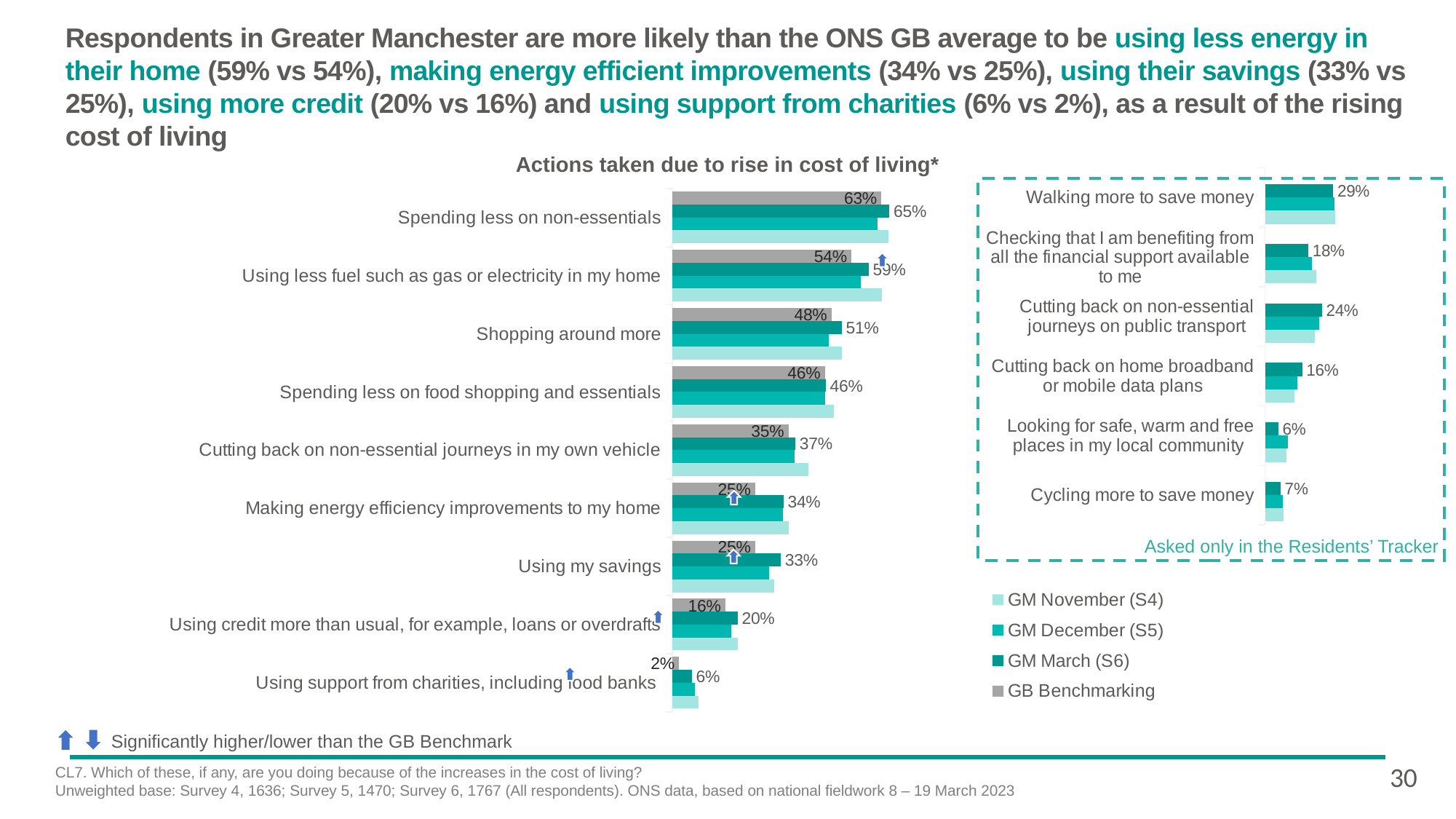
In the 'Actions taken due to rise in cost of living' chart, what is the GB Benchmarking value for 'Using less fuel such as gas or electricity in my home'? 54% In the 'Actions taken due to rise in cost of living' chart, what is the GM March (S6) value for 'Spending less on non-essentials'? 65% In the 'Actions taken due to rise in cost of living' chart, what is the difference between the GM March (S6) and GB Benchmarking values for 'Making energy efficiency improvements to my home'? 9 percentage points In the dashed-box chart on the right (asked only in the Residents' Tracker), what is the GM March (S6) value for 'Walking more to save money'? 29% How many actions are listed in the 'Actions taken due to rise in cost of living' chart on the left? 9 In the dashed-box chart on the right, which action has the lowest labelled value? Looking for safe, warm and free places in my local community In the 'Actions taken due to rise in cost of living' chart, what is the GM March (S6) value for 'Using my savings'? 33% In the 'Actions taken due to rise in cost of living' chart, which action has the highest GM March (S6) value? Spending less on non-essentials In the 'Actions taken due to rise in cost of living' chart, which action has the lowest GB Benchmarking value? Using support from charities, including food banks What kind of chart is the 'Actions taken due to rise in cost of living' chart? Bar chart In the 'Actions taken due to rise in cost of living' chart, which is larger for 'Shopping around more': the GM March (S6) value or the GB Benchmarking value? GM March (S6) How many series does the legend list for the 'Actions taken due to rise in cost of living' chart? 4